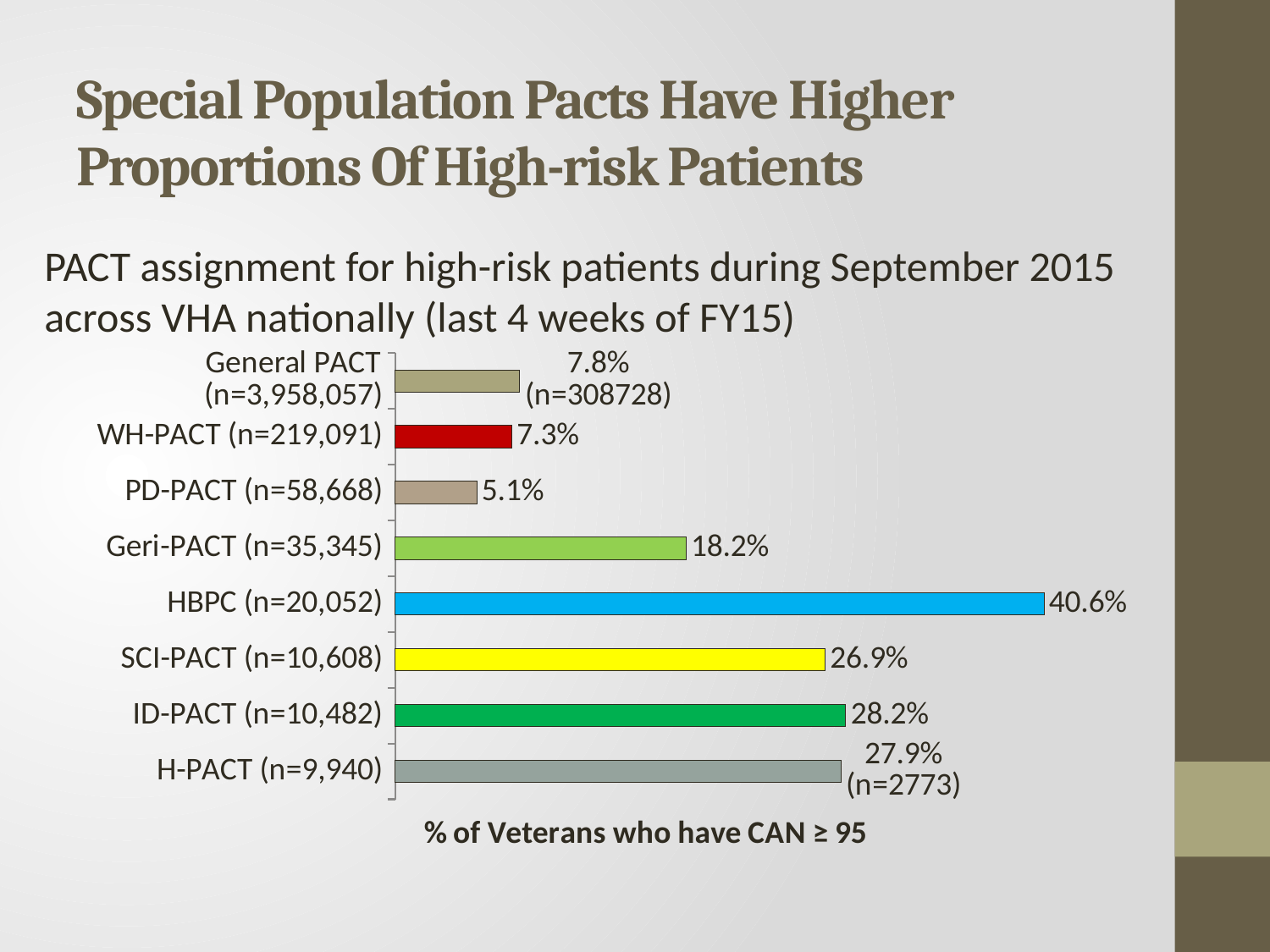
What is the difference in percentage points between General PACT and WH-PACT? 0.5 What is the label on the horizontal axis of the chart? % of Veterans who have CAN ≥ 95 How many PACT categories are plotted in the chart? 8 Which PACT category has the highest percentage of Veterans with CAN ≥ 95? HBPC (n=20,052) What is the value shown for General PACT? 7.8% What is the difference in percentage points between HBPC and Geri-PACT? 22.4 What kind of chart is shown on the slide? Bar chart What percentage is shown for PD-PACT (n=58,668)? 5.1% Which PACT category has the lowest percentage of Veterans with CAN ≥ 95? PD-PACT (n=58,668) Which has a higher percentage, SCI-PACT or HBPC? HBPC What percentage of Veterans in HBPC have CAN ≥ 95? 40.6% What is the value shown for Geri-PACT (n=35,345)? 18.2%